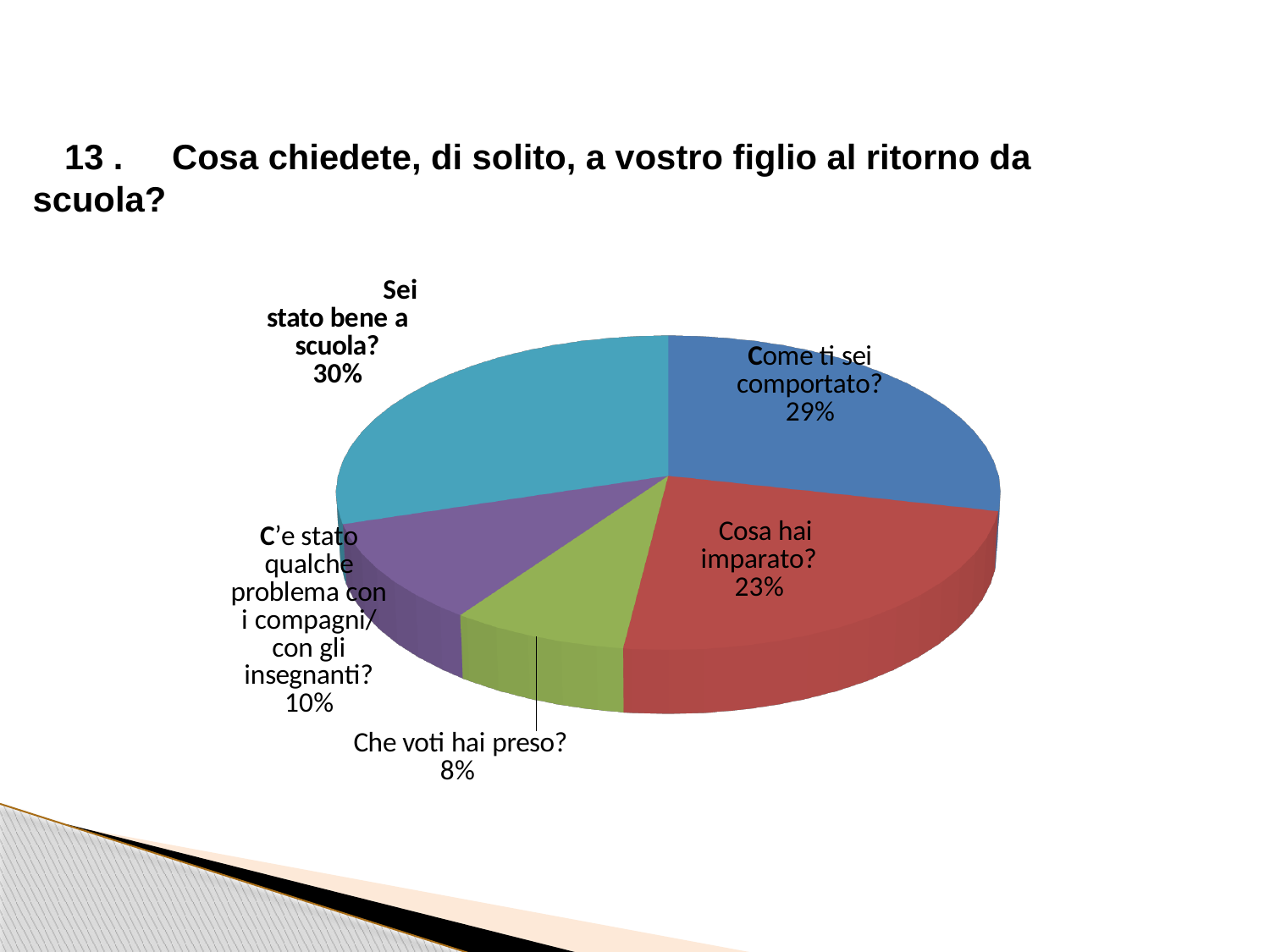
Which slice of the pie is the largest? Sei stato bene a scuola? What kind of chart is shown on the slide? pie chart What share of the pie does "Che voti hai preso?" have? 8% Which slice of the pie is the smallest? Che voti hai preso? Which is larger: the share for "Cosa hai imparato?" or the share for "C'è stato qualche problema con i compagni/con gli insegnanti?"? Cosa hai imparato? What share of the pie does "Come ti sei comportato?" have? 29% What share of the pie does "C'è stato qualche problema con i compagni/con gli insegnanti?" have? 10% What is the difference between the shares for "Come ti sei comportato?" and "Cosa hai imparato?"? 6% What colour is the slice for "Che voti hai preso?"? green How many slices does the pie chart have? 5